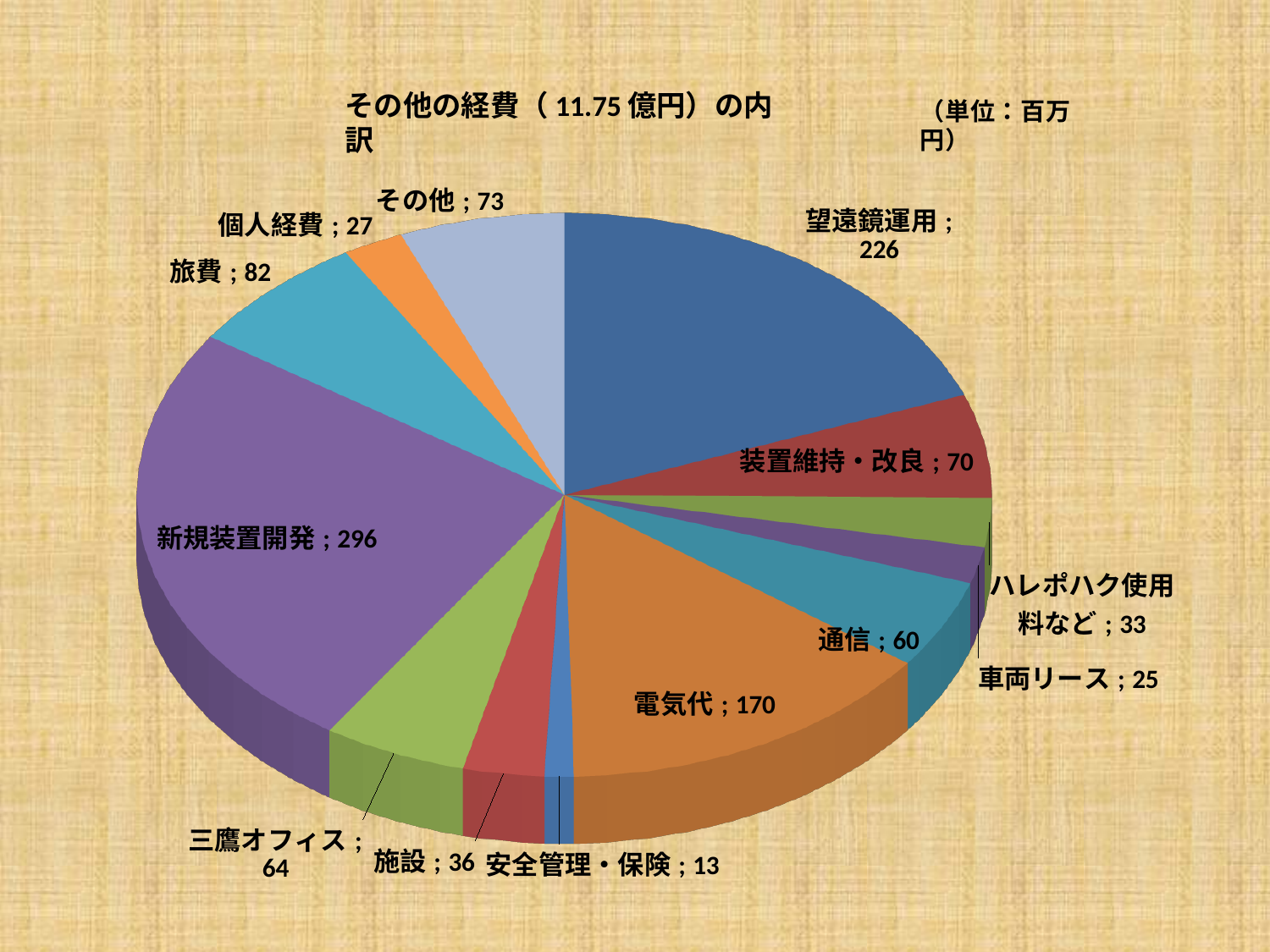
What is the value for 望遠鏡運用? 226 What is the value for 旅費? 82 Which category has the largest slice? 新規装置開発 What unit is stated for the values in the chart? 百万円 Which category has the smallest slice? 安全管理・保険 What is the value for 車両リース? 25 What is the value for 電気代? 170 What is the title of the chart? その他の経費（11.75億円）の内訳 Which is larger, 通信 or 三鷹オフィス? 三鷹オフィス How many categories are shown in the pie chart? 13 What kind of chart is shown on the slide? Pie chart What is the difference between 新規装置開発 and 望遠鏡運用? 70